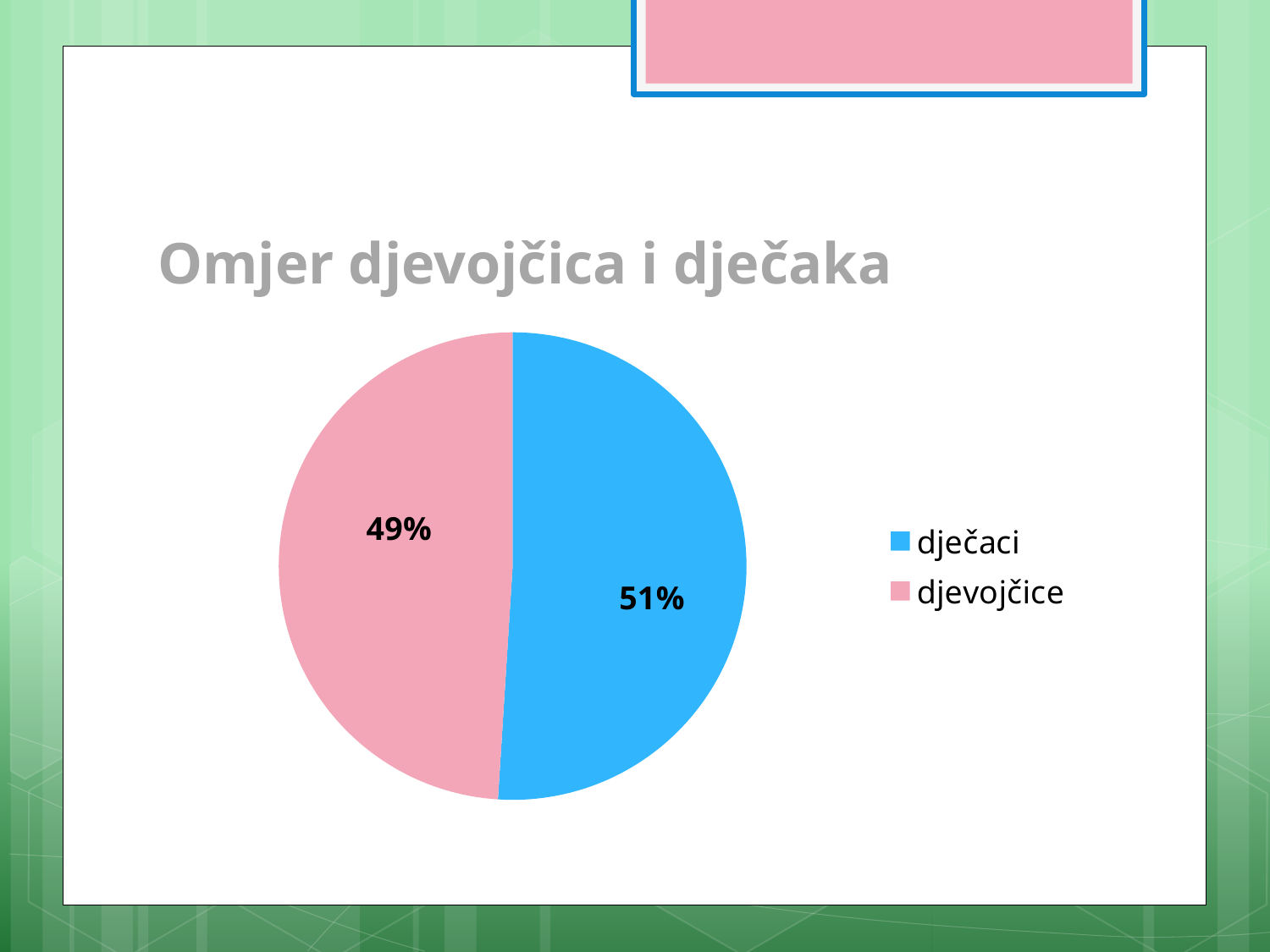
What kind of chart is shown on the slide? pie chart Which category has the largest slice of the pie? dječaci Which category has the smallest slice of the pie? djevojčice What colour is the dječaci slice? blue What is the difference in percentage points between the dječaci and djevojčice slices? 2% How many entries does the legend list? 2 What is the title of the chart? Omjer djevojčica i dječaka What share of the pie does djevojčice represent? 49% How many slices does the pie chart have? 2 What share of the pie does dječaci represent? 51% Which slice is larger, dječaci or djevojčice? dječaci